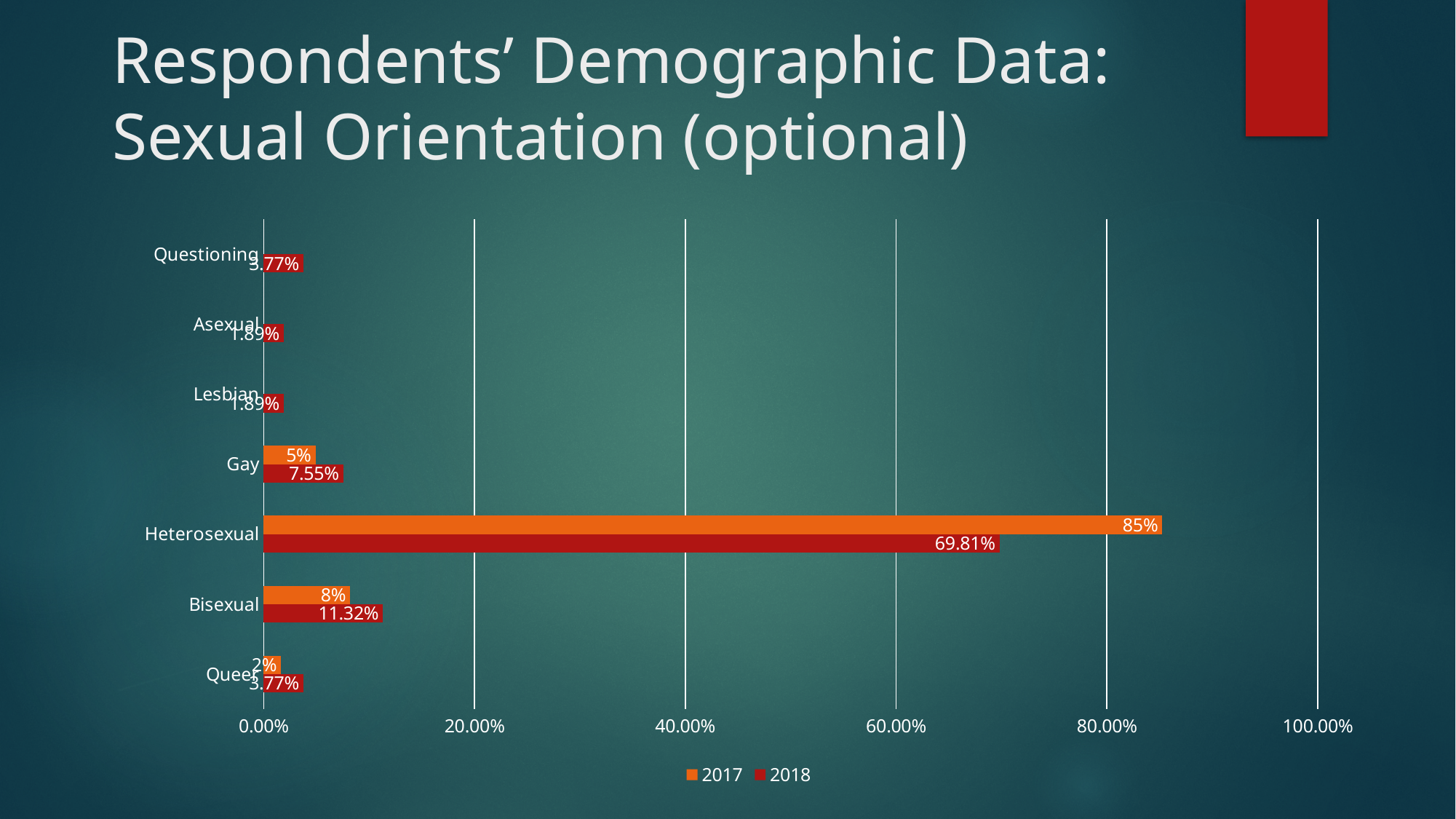
What is the 2018 value for Gay? 7.55% How many categories are shown on the chart? 7 What is the difference between the 2017 and 2018 values for Heterosexual? 15.19% Which is larger for Bisexual, the 2017 value or the 2018 value? 2018 How many series does the legend list? 2 What is the 2018 value for Heterosexual? 69.81% What is the 2017 value for Heterosexual? 85% What kind of chart is shown on the slide? bar chart What is the 2018 value for Bisexual? 11.32% Which series is shown in orange in the legend? 2017 Which category has the highest 2018 value? Heterosexual Which category has the lowest 2017 value among those with a 2017 bar? Queer